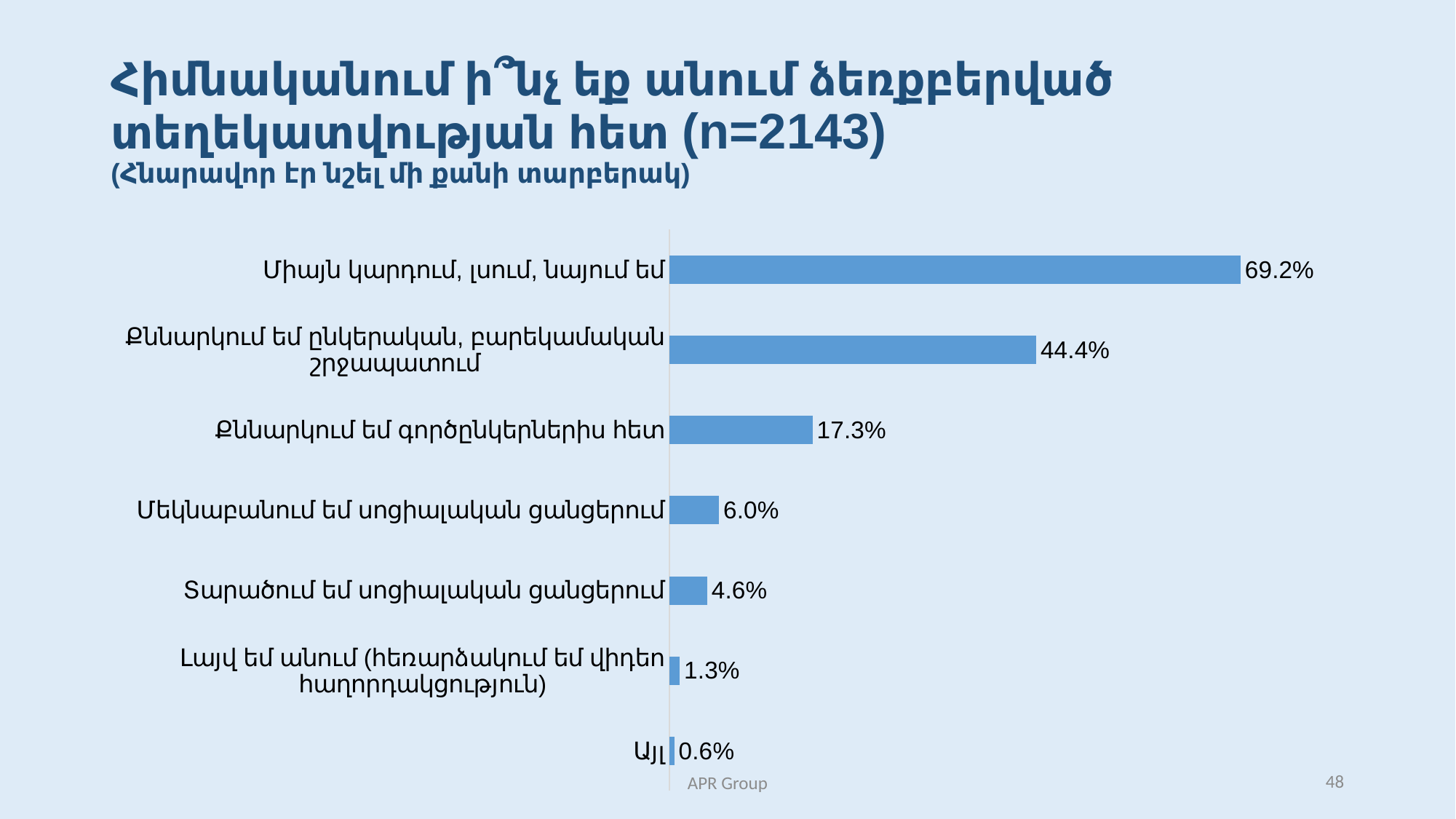
What is the difference between the values for "Միայն կարդում, լսում, նայում եմ" and "Քննարկում եմ ընկերական, բարեկամական շրջապատում"? 24.8% Which category has the lowest value? Այլ What kind of chart is shown on the slide? Bar chart What is the value for "Քննարկում եմ գործընկերներիս հետ"? 17.3% Which is larger: the value for "Քննարկում եմ գործընկերներիս հետ" or the value for "Մեկնաբանում եմ սոցիալական ցանցերում"? Քննարկում եմ գործընկերներիս հետ What is the difference between the values for "Մեկնաբանում եմ սոցիալական ցանցերում" and "Տարածում եմ սոցիալական ցանցերում"? 1.4% What is the value for "Միայն կարդում, լսում, նայում եմ"? 69.2% What is the value for "Տարածում եմ սոցիալական ցանցերում"? 4.6% Which category has the highest value? Միայն կարդում, լսում, նայում եմ What sample size (n) is stated in the slide title? n=2143 What is the value for "Այլ"? 0.6% How many categories are shown in the chart? 7